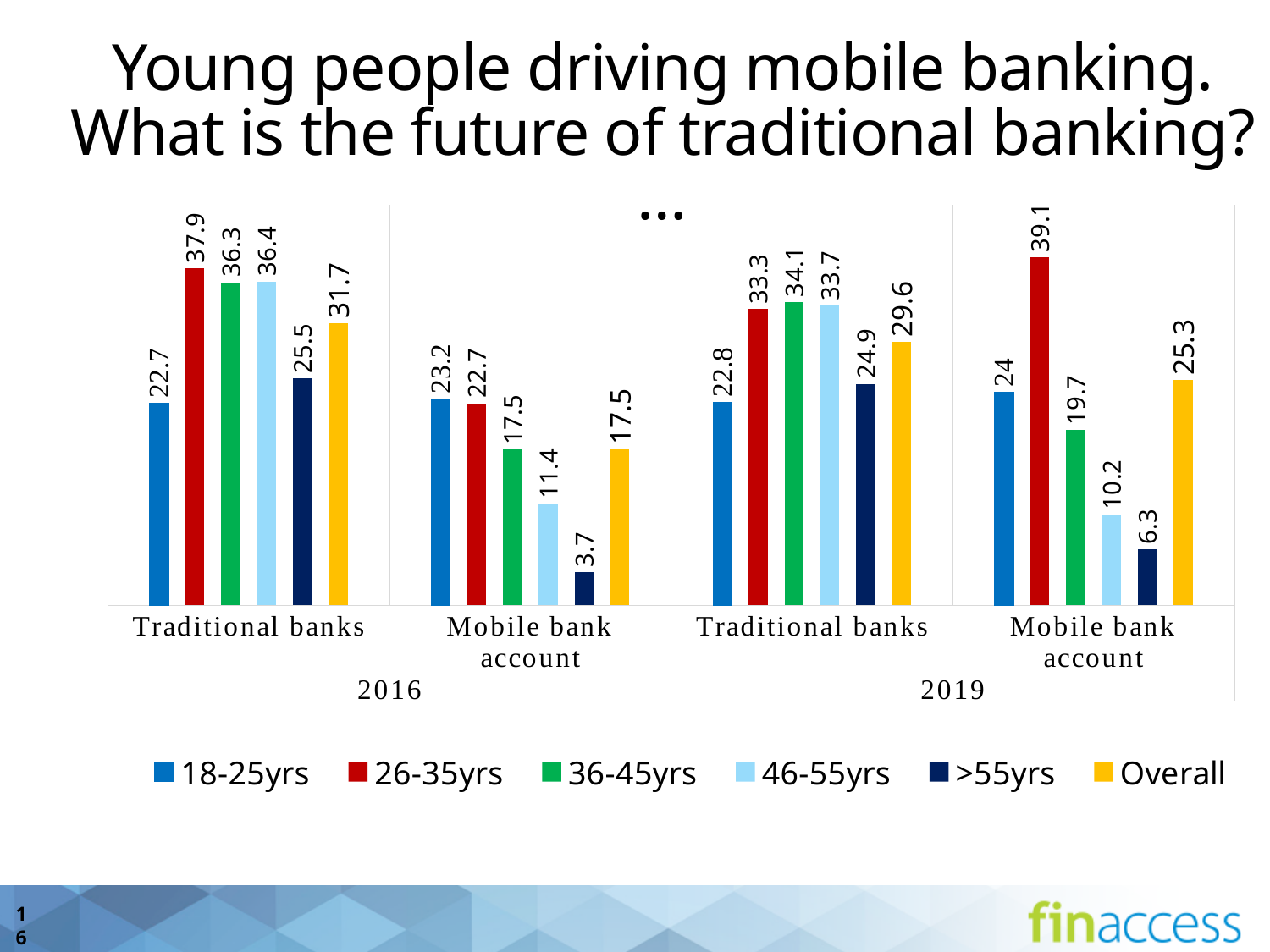
What is the difference between the Overall value for Mobile bank account in 2019 and in 2016? 7.8 What is the value for 26-35yrs for Traditional banks in 2016? 37.9 Which age group has the highest value for Mobile bank account in 2019? 26-35yrs Which colour represents the Overall series in the legend? yellow What kind of chart is shown on the slide? bar chart Which is larger for 46-55yrs in 2019: Traditional banks or Mobile bank account? Traditional banks What is the difference between the 26-35yrs value and the 18-25yrs value for Traditional banks in 2016? 15.2 How many series does the legend list? 6 How many category groups are shown along the x axis? 4 What is the value for >55yrs for Mobile bank account in 2016? 3.7 What is the Overall value for Mobile bank account in 2019? 25.3 Which age group has the lowest value for Traditional banks in 2019? 18-25yrs